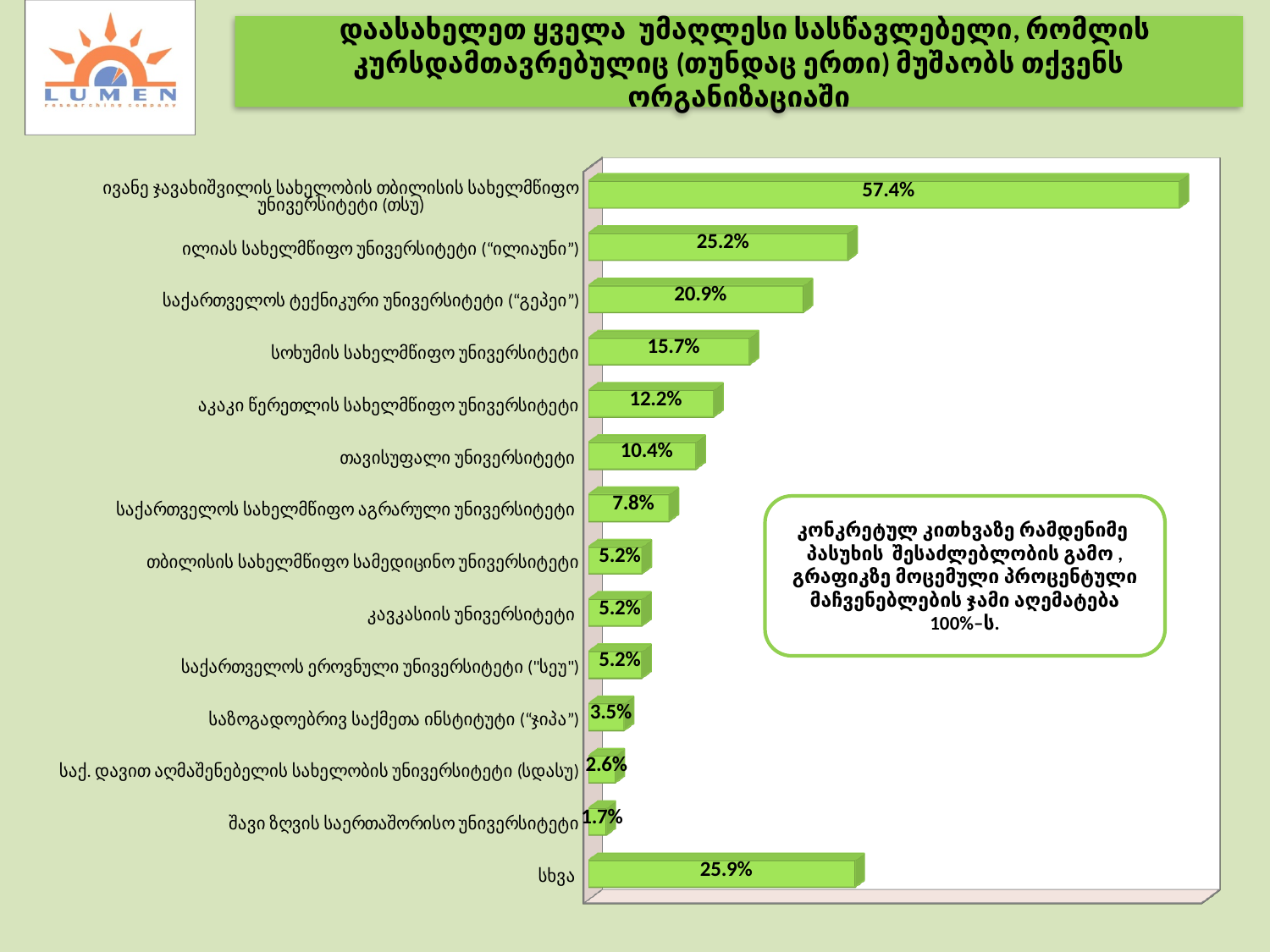
Which category has the lowest value? შავი ზღვის საერთაშორისო უნივერსიტეტი What is the difference between the values for ილიას სახელმწიფო უნივერსიტეტი ("ილიაუნი") and საქართველოს ტექნიკური უნივერსიტეტი ("გეპეი")? 4.3% Which is larger: the value for სხვა or the value for ილიას სახელმწიფო უნივერსიტეტი ("ილიაუნი")? სხვა What is the value for სოხუმის სახელმწიფო უნივერსიტეტი? 15.7% What is the value for შავი ზღვის საერთაშორისო უნივერსიტეტი? 1.7% What is the difference between the values for თავისუფალი უნივერსიტეტი and საქართველოს სახელმწიფო აგრარული უნივერსიტეტი? 2.6% What is the value for ივანე ჯავახიშვილის სახელობის თბილისის სახელმწიფო უნივერსიტეტი (თსუ)? 57.4% What is the value for სხვა? 25.9% What colour are the bars in the chart? green What kind of chart is shown on the slide? bar chart How many categories (bars) does the chart show? 14 Which category has the highest value? ივანე ჯავახიშვილის სახელობის თბილისის სახელმწიფო უნივერსიტეტი (თსუ)